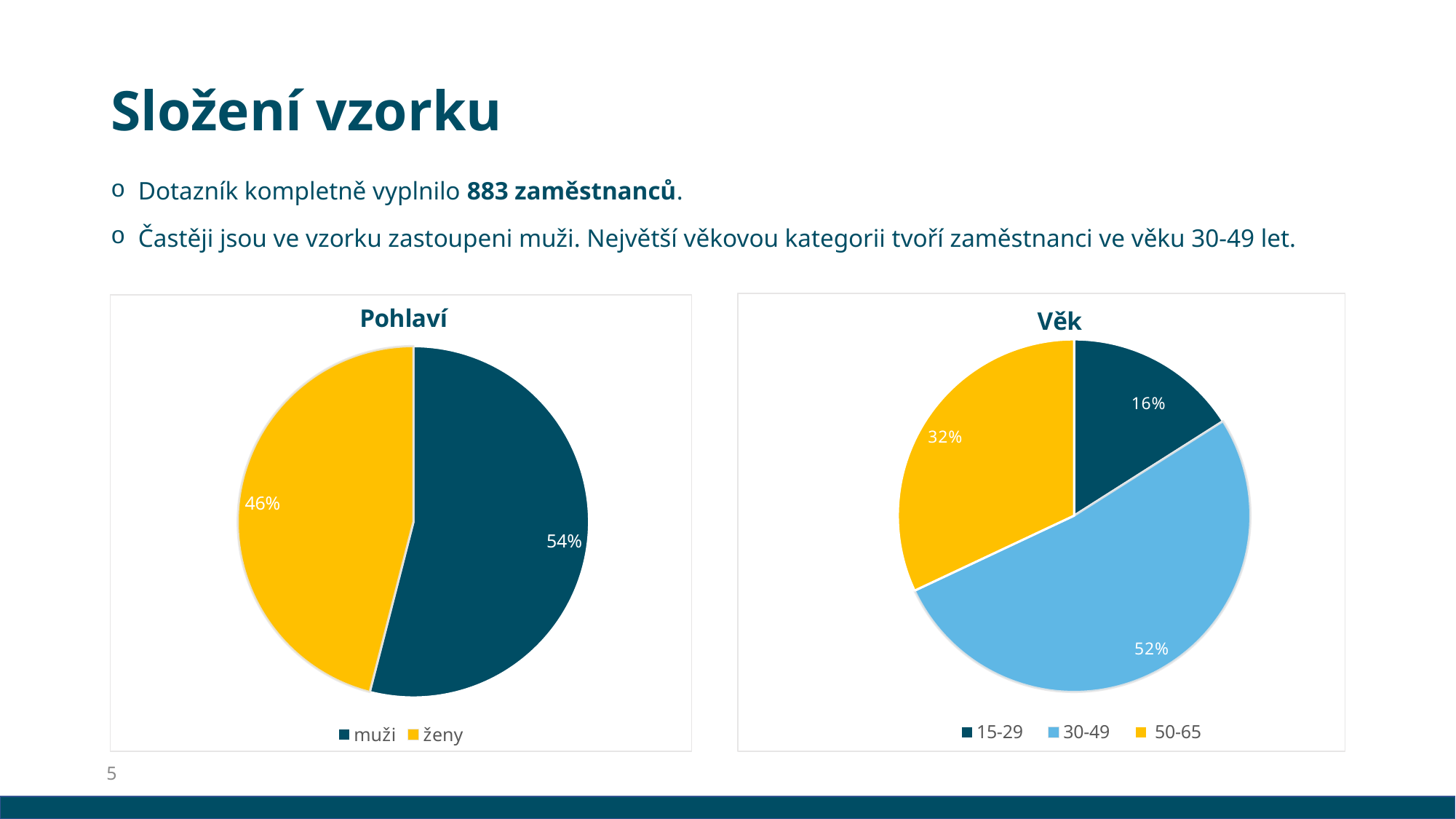
In the 'Věk' chart, what share of the sample is aged 50-65? 32% In the 'Pohlaví' chart, what is the difference in percentage points between 'muži' and 'ženy'? 8 In the 'Věk' chart, what share of the sample is aged 15-29? 16% In the 'Věk' chart, what share of the sample is aged 30-49? 52% In the 'Pohlaví' chart, what share of the sample is 'muži'? 54% How many categories does the legend of the 'Věk' chart list? 3 In the 'Věk' chart, which age category has the largest share? 30-49 In the 'Věk' chart, which age category has the smallest share? 15-29 In the 'Pohlaví' chart, which category has the larger share? muži In the 'Věk' chart, what is the difference in percentage points between the 50-65 and 15-29 categories? 16 In the 'Pohlaví' chart, what share of the sample is 'ženy'? 46% What kind of chart is the 'Pohlaví' chart? pie chart